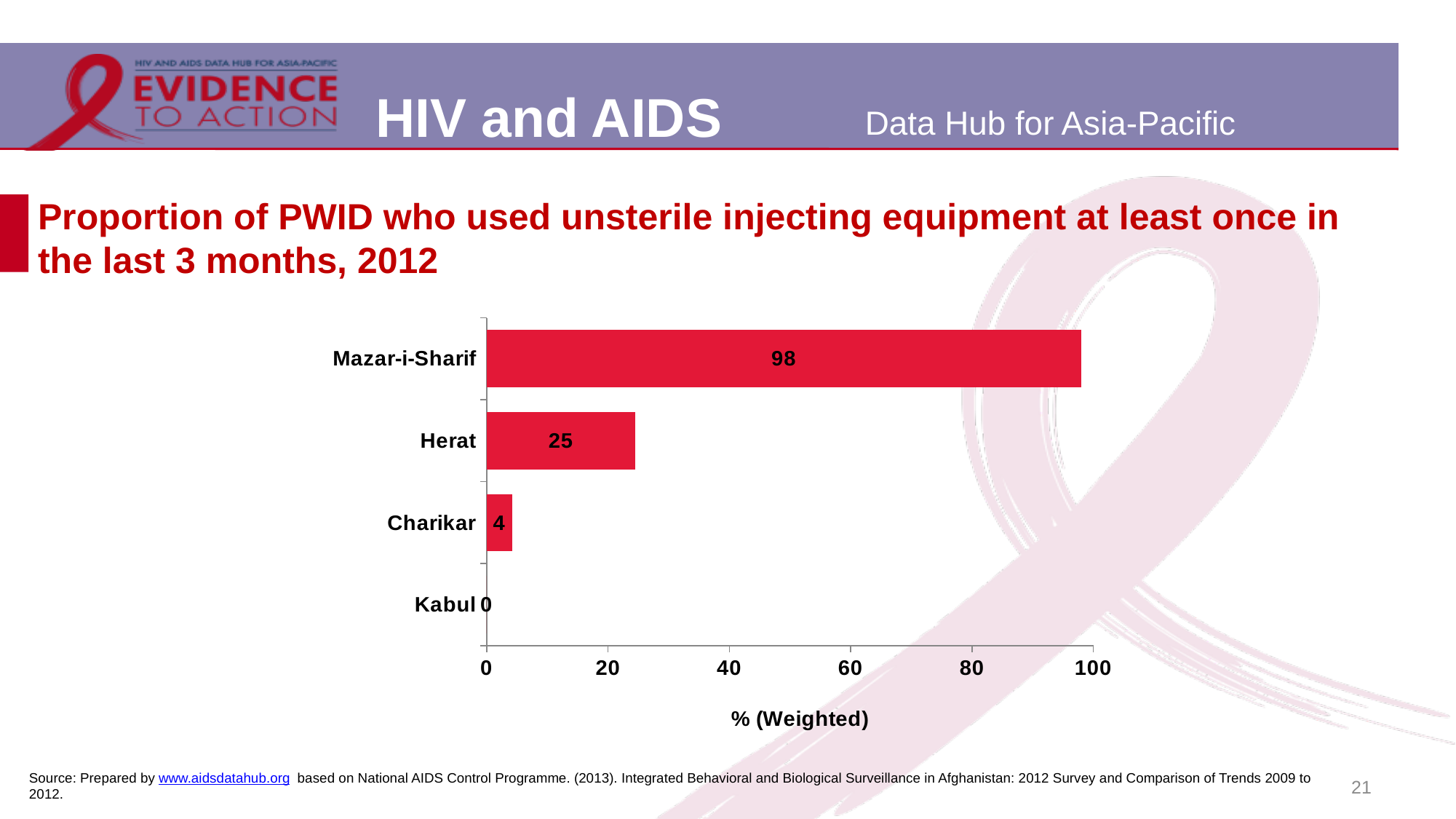
What is the value for Charikar? 4 What kind of chart is shown on the slide? bar chart Which is larger, the value for Herat or the value for Charikar? Herat Which city has the highest proportion? Mazar-i-Sharif Is the value for Herat greater or less than 40? less What is the value for Herat? 25 What is the value for Kabul? 0 How many cities are shown in the chart? 4 What is the difference between the values for Herat and Charikar? 21 Which city has the lowest proportion? Kabul What is the difference between the values for Mazar-i-Sharif and Herat? 73 What is the value for Mazar-i-Sharif? 98